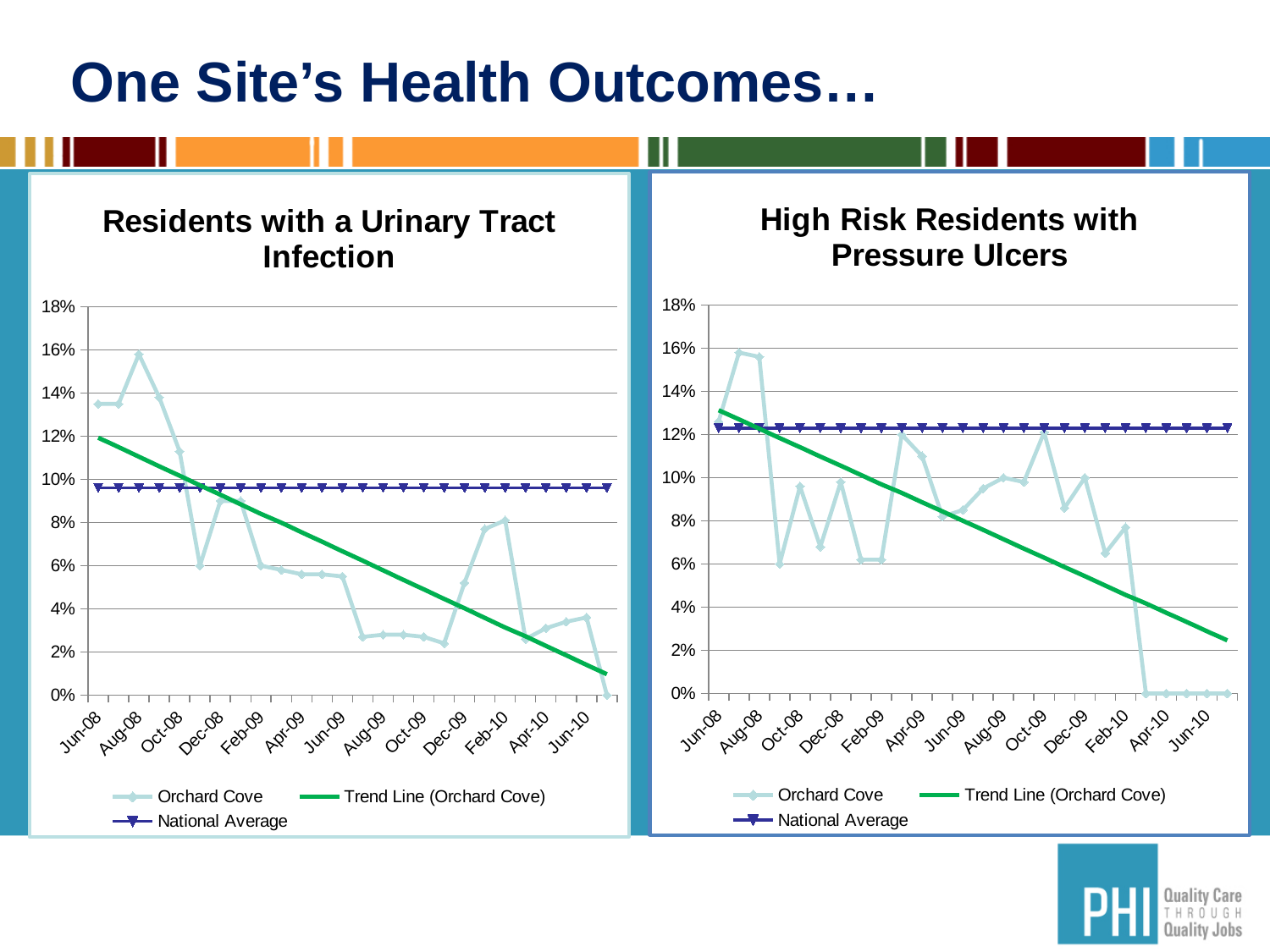
In the 'Residents with a Urinary Tract Infection' chart, is the Orchard Cove value for Jun-08 greater or less than 12%? greater In the 'Residents with a Urinary Tract Infection' chart, which is larger for Orchard Cove: the value at Jun-08 or the value at Jun-10? Jun-08 What is the title of the chart on the right side of the slide? High Risk Residents with Pressure Ulcers In the 'Residents with a Urinary Tract Infection' chart, is the National Average line greater or less than 10%? less In the 'High Risk Residents with Pressure Ulcers' chart, what is the Orchard Cove value for Jun-10? 0% In the 'Residents with a Urinary Tract Infection' chart, does the Orchard Cove trend line rise or fall from Jun-08 to Jun-10? fall What kind of chart is the 'Residents with a Urinary Tract Infection' chart? line chart In the 'High Risk Residents with Pressure Ulcers' chart, is the National Average line greater or less than 12%? greater How many series does the legend of the 'High Risk Residents with Pressure Ulcers' chart list? 3 In the 'Residents with a Urinary Tract Infection' chart, at which labelled month does the Orchard Cove line reach its highest value? Aug-08 In the 'High Risk Residents with Pressure Ulcers' chart, does the Orchard Cove trend line rise or fall over time? fall